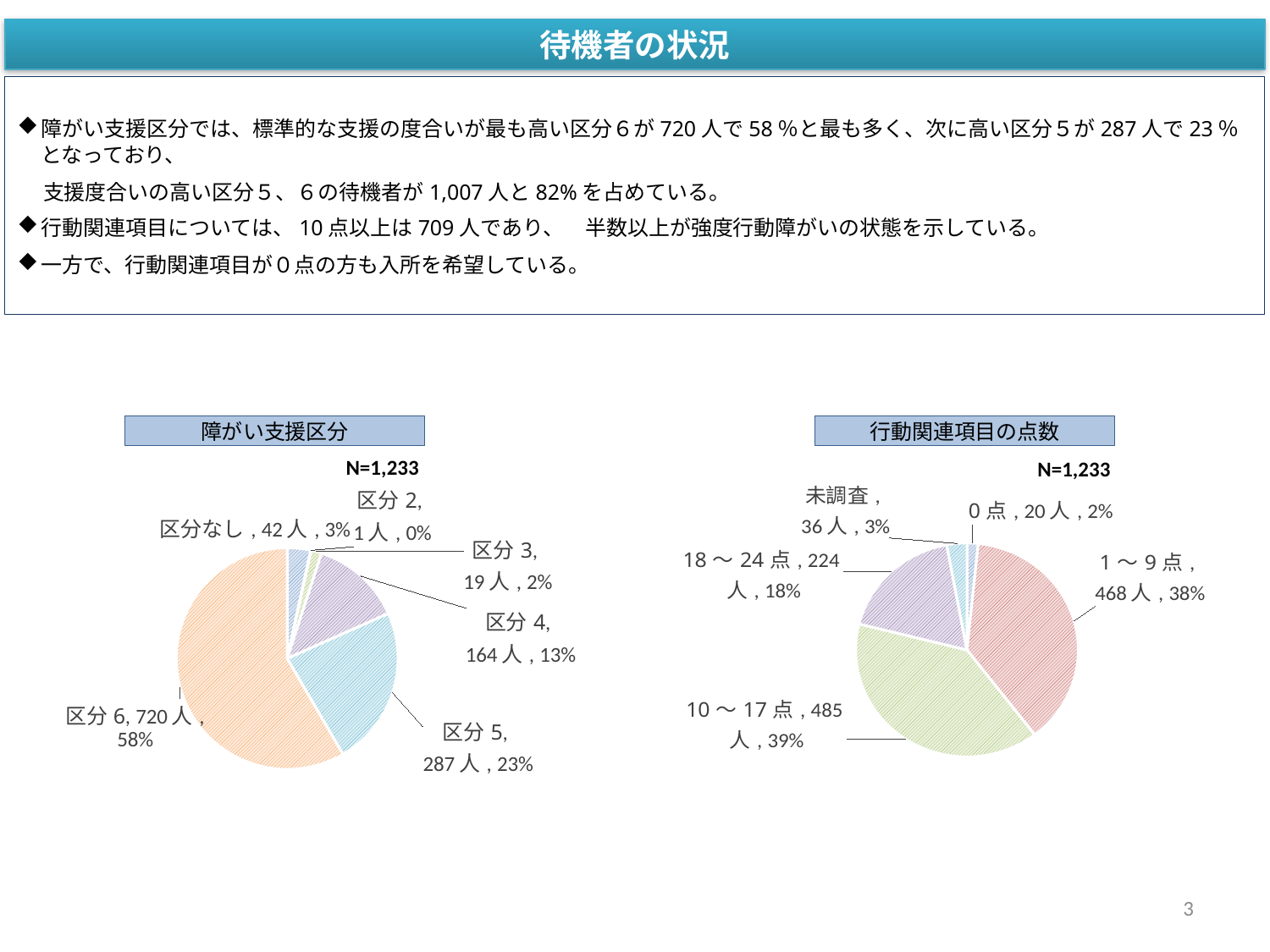
In the 障がい支援区分 pie chart, what share of the pie does 区分 5 represent? 23% In the 障がい支援区分 pie chart, how many categories are shown? 6 In the 障がい支援区分 pie chart, how many people are in 区分 6? 720 人 In the 障がい支援区分 pie chart, which category has the largest slice? 区分 6 In the 障がい支援区分 pie chart, which category has the smallest slice? 区分 2 In the 行動関連項目の点数 pie chart, which is larger, 未調査 or 0 点? 未調査 In the 行動関連項目の点数 pie chart, which category has the largest slice? 10 〜 17 点 In the 障がい支援区分 pie chart, what is the difference in people between 区分 5 and 区分 4? 123 人 What type of chart is used for 行動関連項目の点数? Pie chart In the 行動関連項目の点数 pie chart, what share of the pie does 18 〜 24 点 represent? 18% What is the N value shown above the 障がい支援区分 pie chart? N=1,233 In the 行動関連項目の点数 pie chart, how many people scored 10 〜 17 点? 485 人